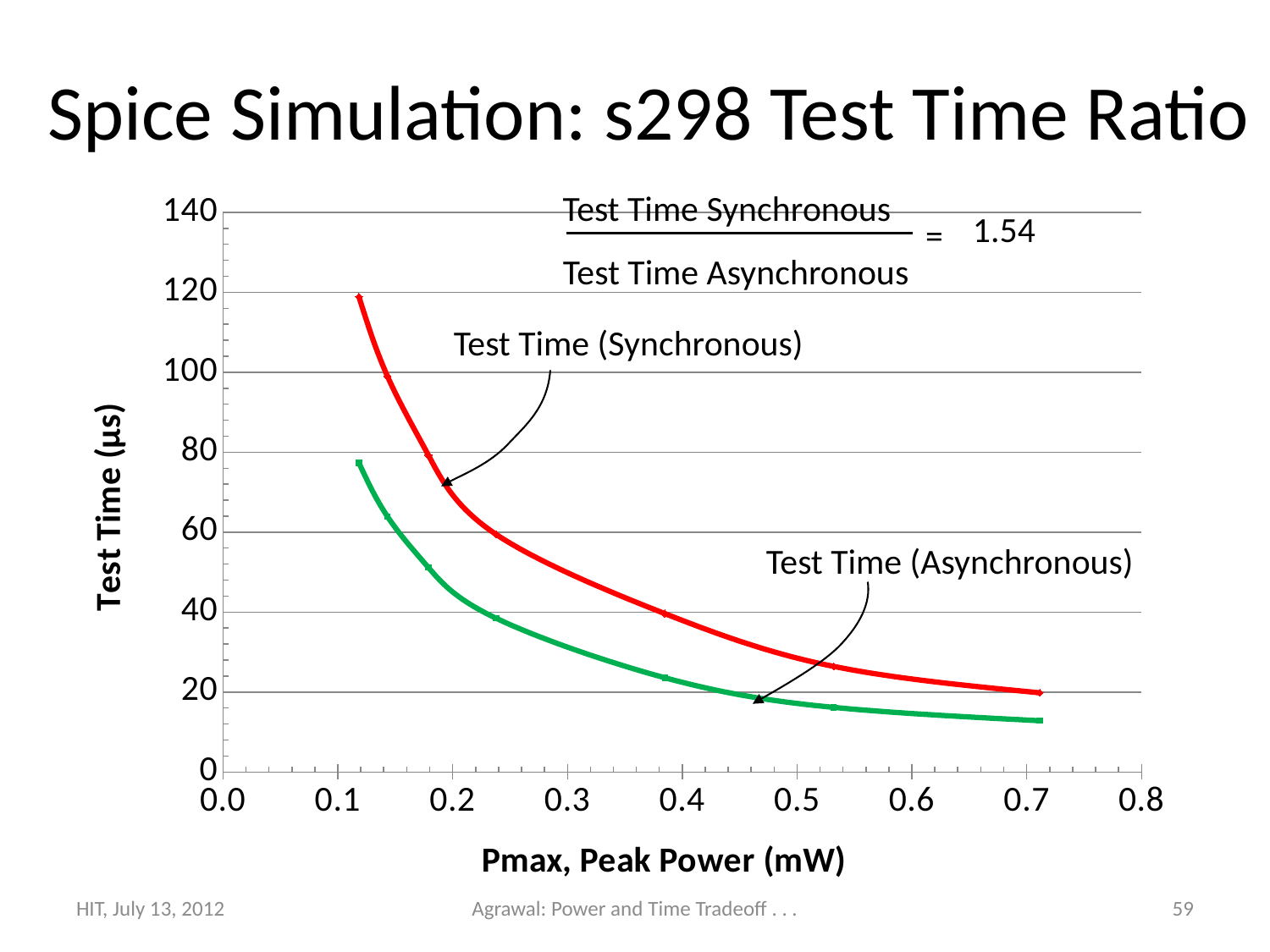
What is the title of the x axis of the chart? Pmax, Peak Power (mW) Is the Test Time (Asynchronous) value at its leftmost point (Pmax about 0.12 mW) greater or less than 60? greater Which series has the higher test time at a Pmax of 0.2 mW, Test Time (Synchronous) or Test Time (Asynchronous)? Test Time (Synchronous) Is the Test Time (Synchronous) value at Pmax 0.4 mW greater or less than 60? less What kind of chart is shown on the slide? line chart How many data series are plotted on the chart? 2 Which series has the lower test time at a Pmax of 0.5 mW, Test Time (Synchronous) or Test Time (Asynchronous)? Test Time (Asynchronous) As Pmax increases along the x axis, do the test time values rise or fall? fall Is the Test Time (Synchronous) value at its leftmost point (Pmax about 0.12 mW) greater or less than 100? greater What value is given on the chart for the ratio of Test Time Synchronous to Test Time Asynchronous? 1.54